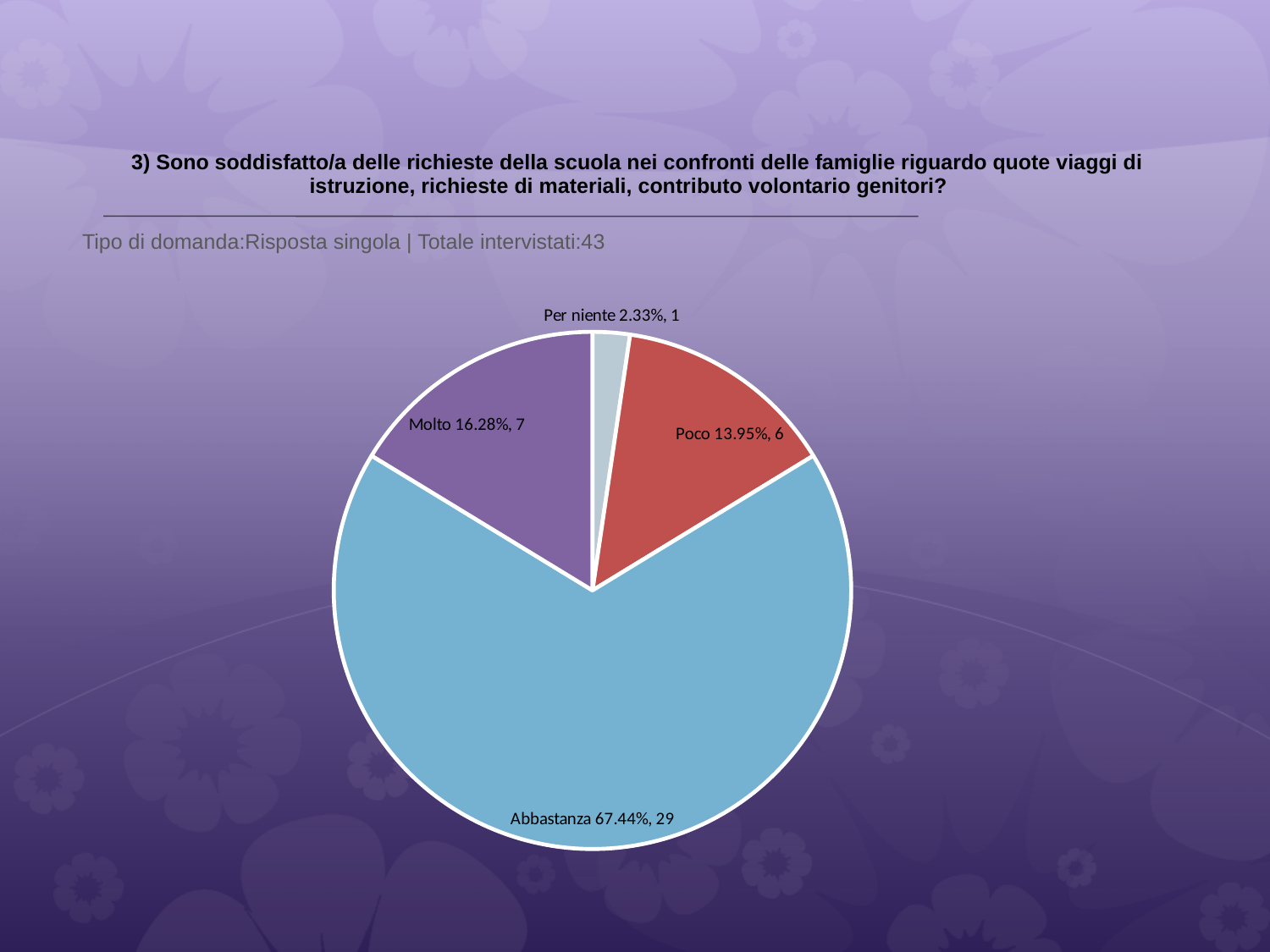
What colour is the 'Abbastanza' slice? light blue How many respondents answered 'Molto'? 7 What percentage share does the 'Per niente' slice represent? 2.33% What percentage share does the 'Abbastanza' slice represent? 67.44% How many respondents answered 'Poco'? 6 Which has more respondents, 'Molto' or 'Poco'? Molto How many slices does the pie chart have? 4 Which category has the largest slice of the pie? Abbastanza What kind of chart is shown on the slide? pie chart What is the total number of respondents across all slices? 43 Which category has the smallest slice of the pie? Per niente What is the difference in number of respondents between 'Abbastanza' and 'Molto'? 22